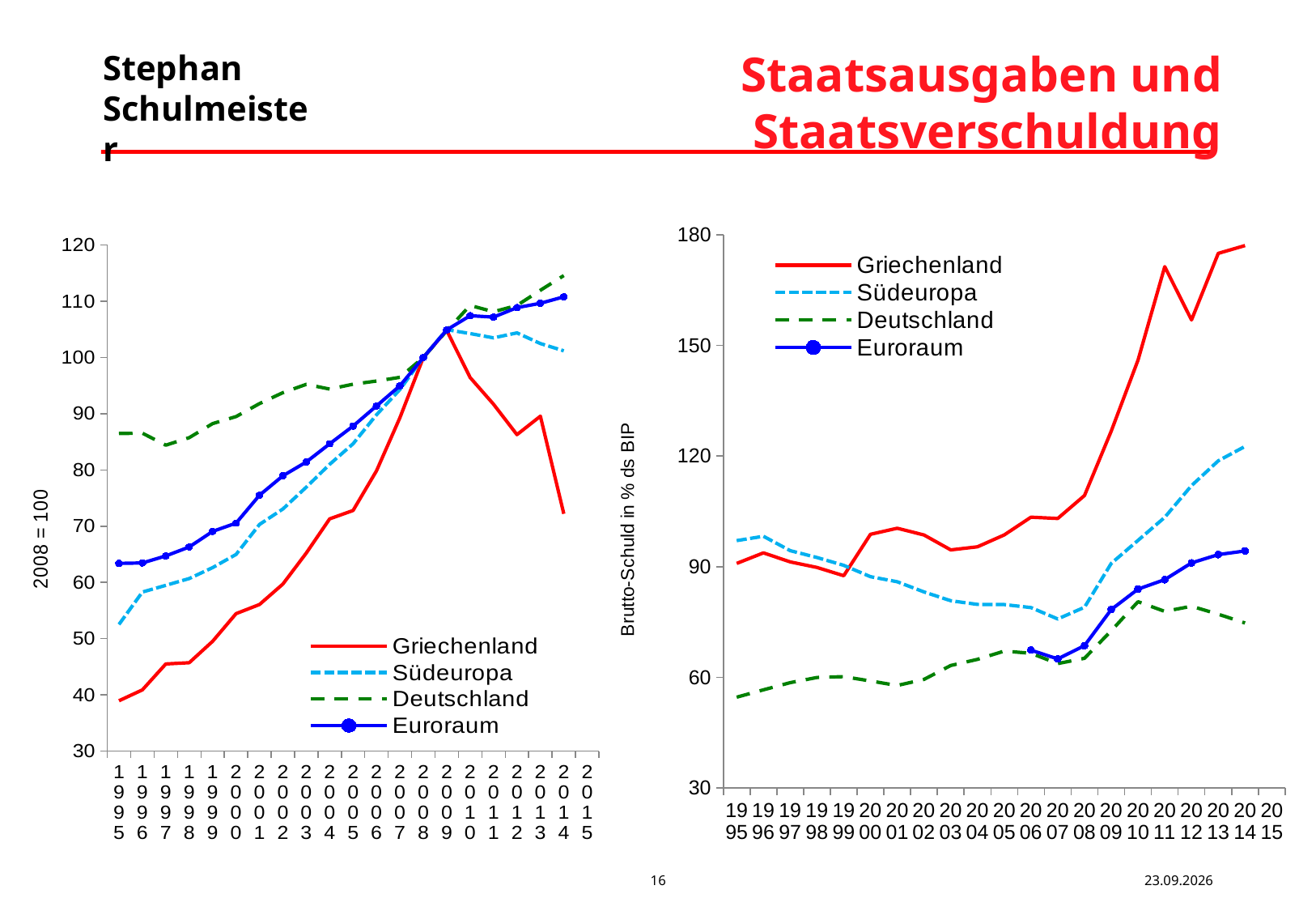
What kind of chart is the left chart on the slide? line chart In the right chart, which series has the highest value in 2014? Griechenland What is the y-axis label of the right chart? Brutto-Schuld in % ds BIP In the right chart, is the value for Griechenland in 2014 greater or less than 150? greater In the left chart, what is the value for Euroraum in 2008? 100 How many series does the legend of the right chart list? 4 In the left chart, does the Griechenland line rise or fall from 2009 to 2014? fall In the left chart, is the value for Griechenland in 2014 greater or less than 80? less In the left chart, is the value for Deutschland in 1995 greater or less than 80? greater In the right chart, which series has the lowest value in 2014? Deutschland In the left chart, which is larger in 2014, Deutschland or Südeuropa? Deutschland